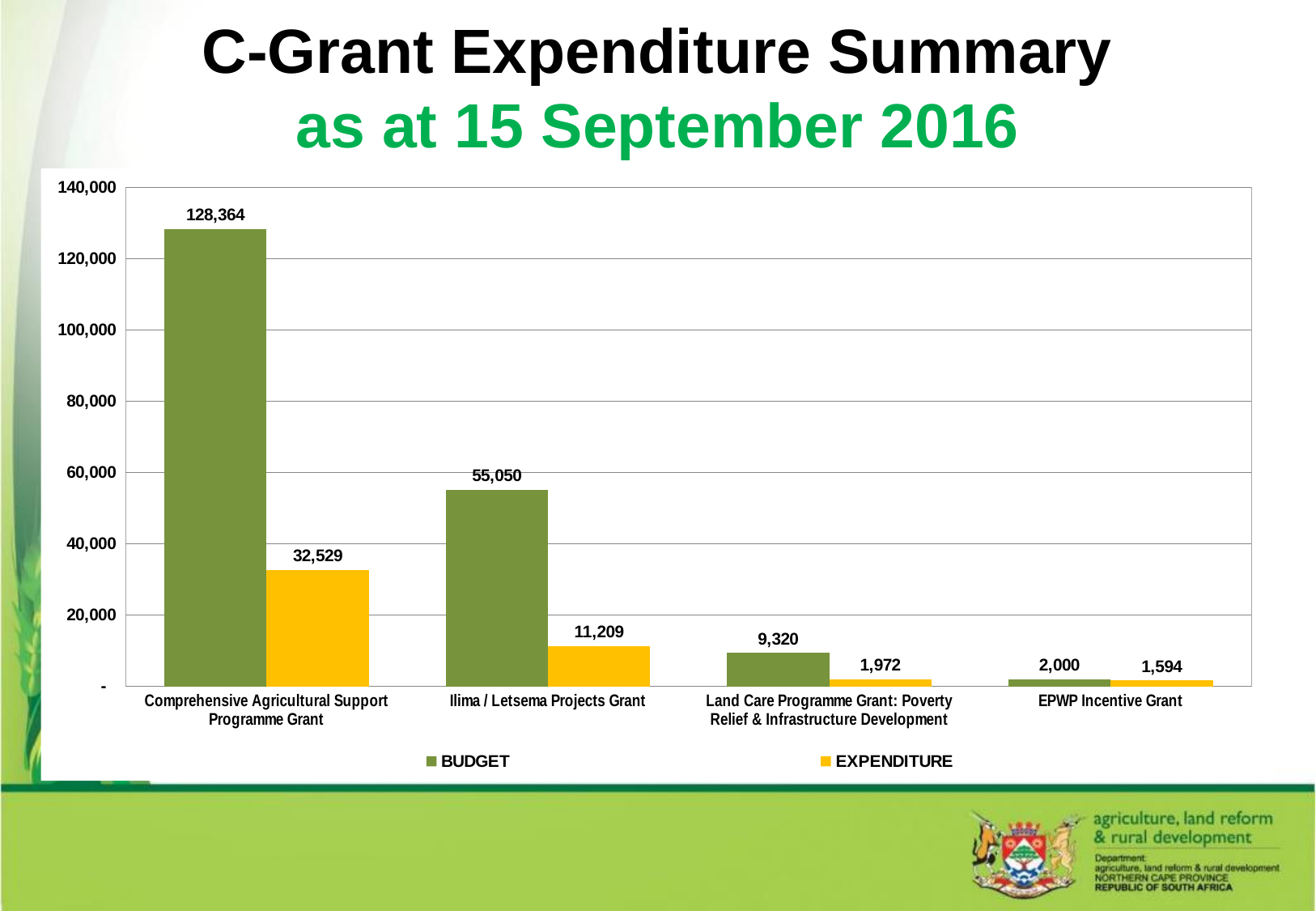
What is the difference between the BUDGET and EXPENDITURE values for the Land Care Programme Grant: Poverty Relief & Infrastructure Development? 7,348 What kind of chart is shown on the slide? bar chart Which is larger: the BUDGET for the Ilima / Letsema Projects Grant or the EXPENDITURE for the Comprehensive Agricultural Support Programme Grant? BUDGET for the Ilima / Letsema Projects Grant What colour are the EXPENDITURE bars? yellow Which grant has the highest BUDGET value? Comprehensive Agricultural Support Programme Grant Is the BUDGET value for the Ilima / Letsema Projects Grant greater or less than 60,000? less What is the EXPENDITURE value for the EPWP Incentive Grant? 1,594 How many series does the legend list? 2 What is the BUDGET value for the Comprehensive Agricultural Support Programme Grant? 128,364 What is the EXPENDITURE value for the Ilima / Letsema Projects Grant? 11,209 Which grant has the lowest EXPENDITURE value? EPWP Incentive Grant How many grant categories are shown on the x axis? 4